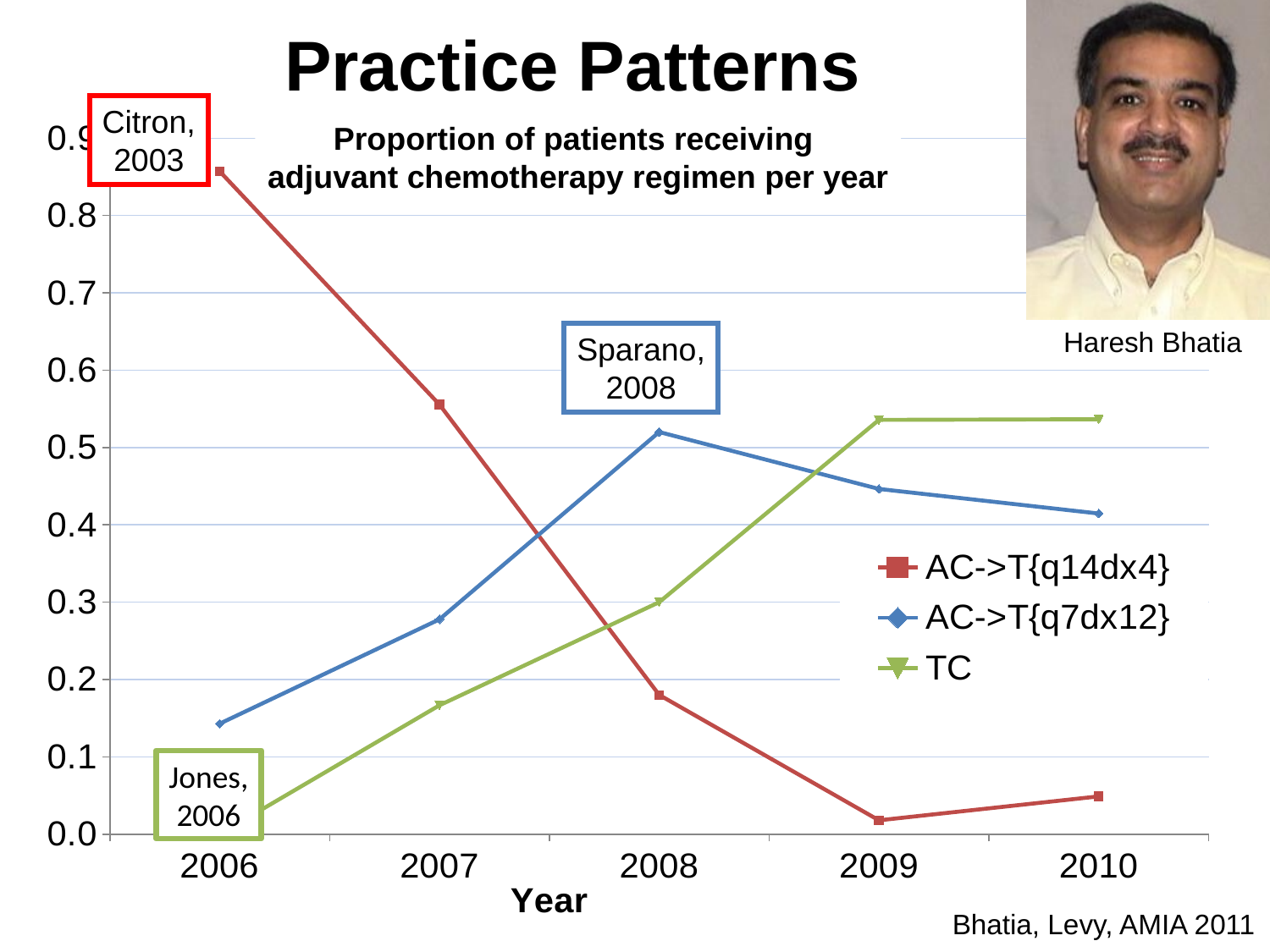
In 2010, which is larger: TC or AC->T{q7dx12}? TC How many years are plotted along the x axis? 5 Does the AC->T{q14dx4} line rise or fall from 2006 to 2009? fall In which year does the AC->T{q7dx12} line reach its highest value? 2008 Is the value for TC in 2006 greater or less than 0.1? less What is the title of the x axis? Year Is the value for AC->T{q14dx4} in 2006 greater or less than 0.8? greater Is the value for TC in 2009 greater or less than 0.5? greater Which series has the lowest value in 2009? AC->T{q14dx4} Which series has the highest value in 2008? AC->T{q7dx12} What kind of chart is shown on the slide? line chart How many series does the legend list? 3